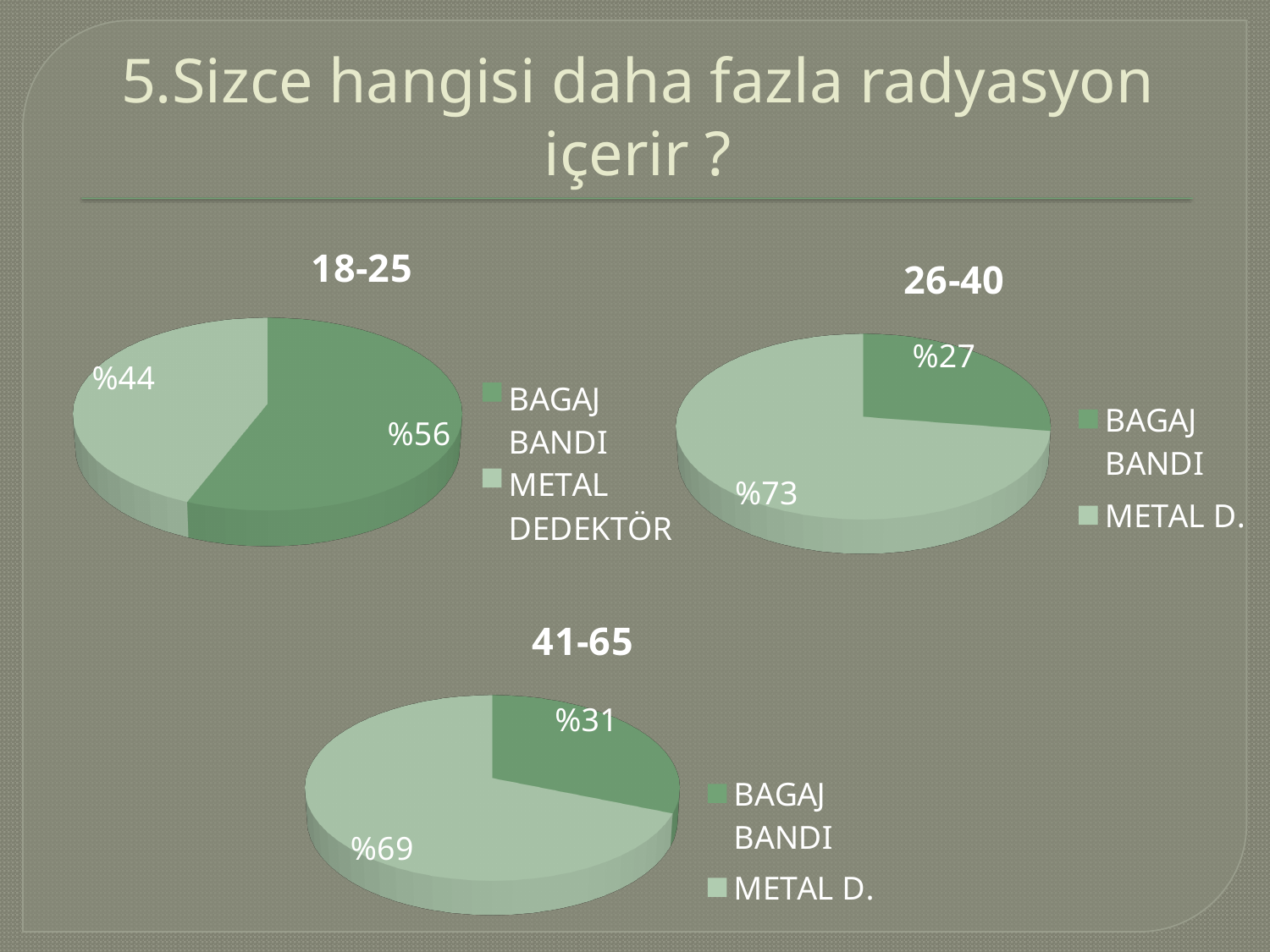
In the 41-65 chart, what is the value for BAGAJ BANDI? %31 In the 41-65 chart, what is the difference between the METAL D. and BAGAJ BANDI values? %38 In the 26-40 chart, which is larger, BAGAJ BANDI or METAL D.? METAL D. In the 18-25 chart, what is the value for METAL DEDEKTÖR? %44 In the 26-40 chart, which category has the smallest slice? BAGAJ BANDI In the 26-40 chart, what is the value for BAGAJ BANDI? %27 In the 26-40 chart, what is the value for METAL D.? %73 In the 18-25 chart, which category has the largest slice? BAGAJ BANDI In the 18-25 chart, what is the value for BAGAJ BANDI? %56 In the 41-65 chart, what is the value for METAL D.? %69 What kind of chart is the 41-65 chart? Pie chart How many slices does the 18-25 chart have? 2